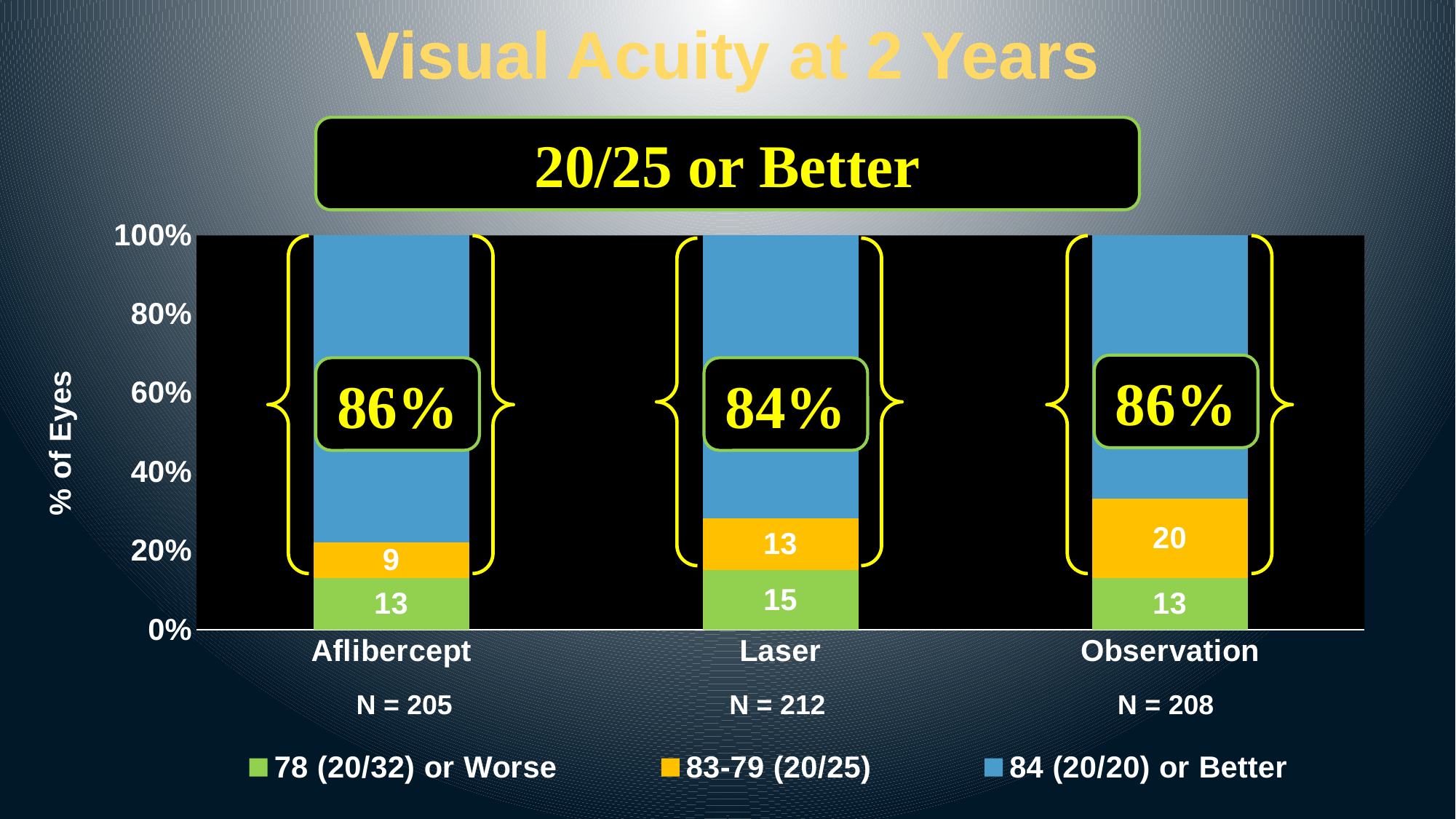
What kind of chart is shown on the slide? Stacked bar chart What percentage of eyes in the Laser group achieved 20/25 or better? 84% Is the 84 (20/20) or Better segment for Aflibercept greater or less than 60%? greater Which category has the lowest value for the 83-79 (20/25) series? Aflibercept Which is larger: the 78 (20/32) or Worse value for Laser or for Observation? Laser What is the value of the 83-79 (20/25) segment for Aflibercept? 9 What is the value of the 78 (20/32) or Worse segment for Laser? 15 Which category has the highest value for the 83-79 (20/25) series? Observation How many categories are shown on the x axis? 3 What is the difference between the 83-79 (20/25) values for Observation and Aflibercept? 11 What is the value of the 83-79 (20/25) segment for Observation? 20 How many series does the legend list? 3